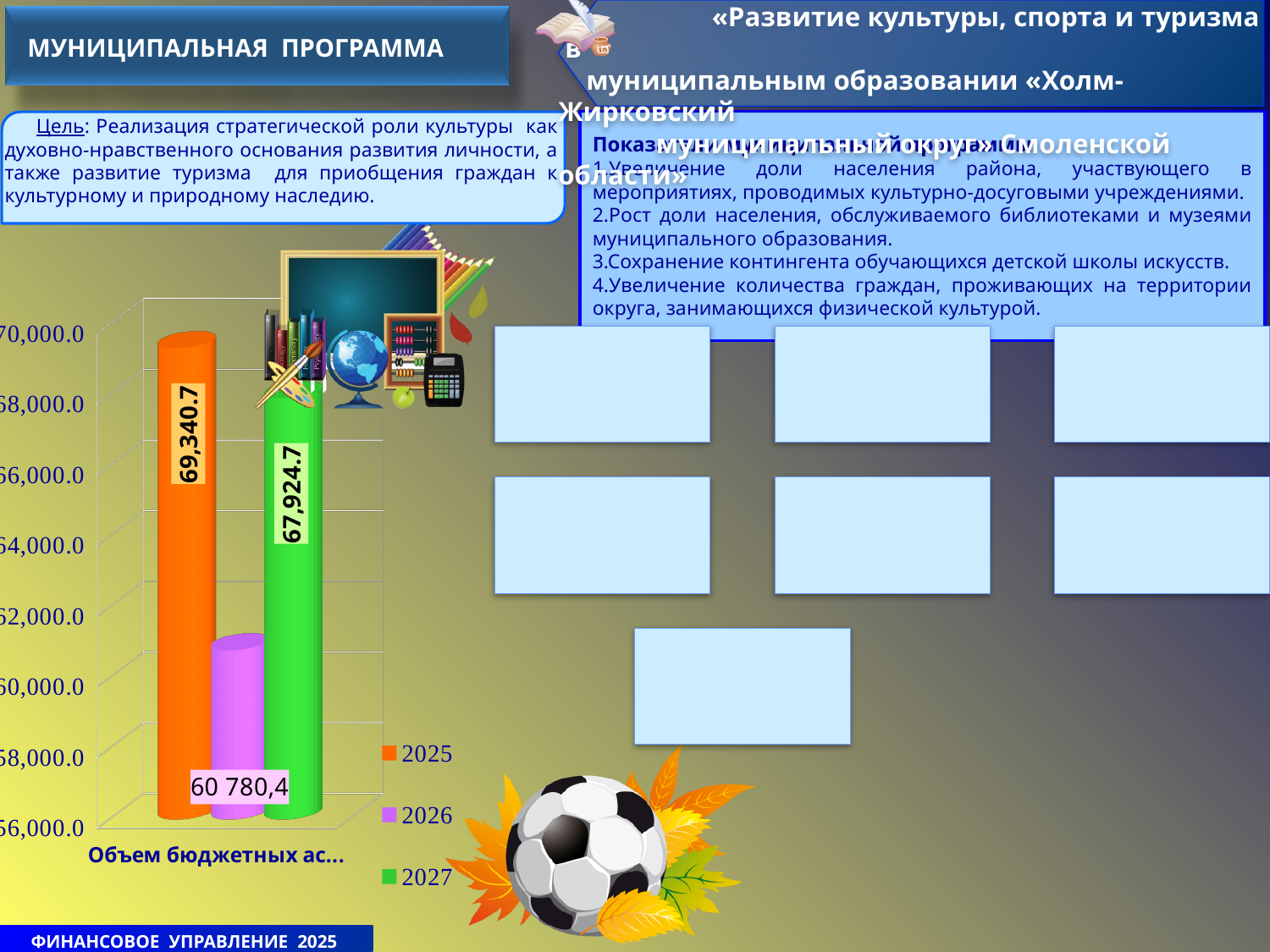
What is the difference between the 2025 value and the 2027 value? 1,416.0 Which is larger, the value for 2026 or the value for 2027? 2027 Is the value for 2027 greater or less than 66,000.0? greater What colour is the bar for the 2025 series? orange What is the value for the 2027 series? 67,924.7 Which series has the highest value? 2025 How many series does the legend list? 3 What is the value for the 2025 series? 69,340.7 Which series has the lowest value? 2026 What kind of chart is shown on the slide? bar chart What is the value for the 2026 series? 60 780,4 Is the value for 2026 greater or less than 62,000.0? less